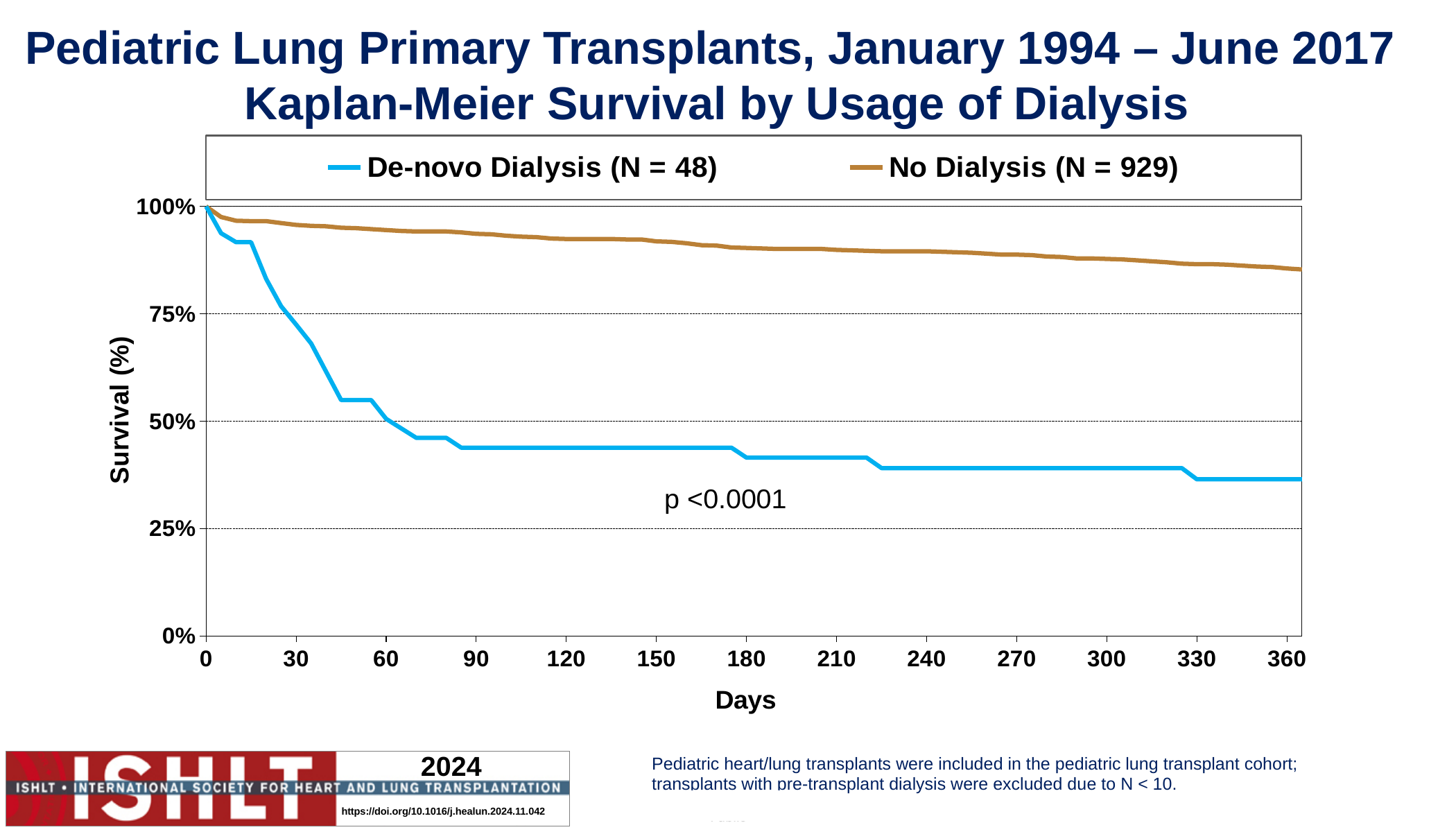
Is the survival value for the No Dialysis series at day 180 greater or less than 75%? greater What p-value is printed on the chart? p <0.0001 What kind of chart is shown on the slide? line chart Is the survival value for the De-novo Dialysis series at day 90 greater or less than 50%? less What is the N for the No Dialysis group shown in the legend? 929 Is the survival value for the No Dialysis series at day 360 greater or less than 75%? greater Which series has the higher survival at day 180, De-novo Dialysis or No Dialysis? No Dialysis Does the survival for the De-novo Dialysis series rise or fall as days increase? fall What is the survival value for the De-novo Dialysis series at day 0? 100% Which series shows the lowest survival at day 360? De-novo Dialysis How many series does the legend list? 2